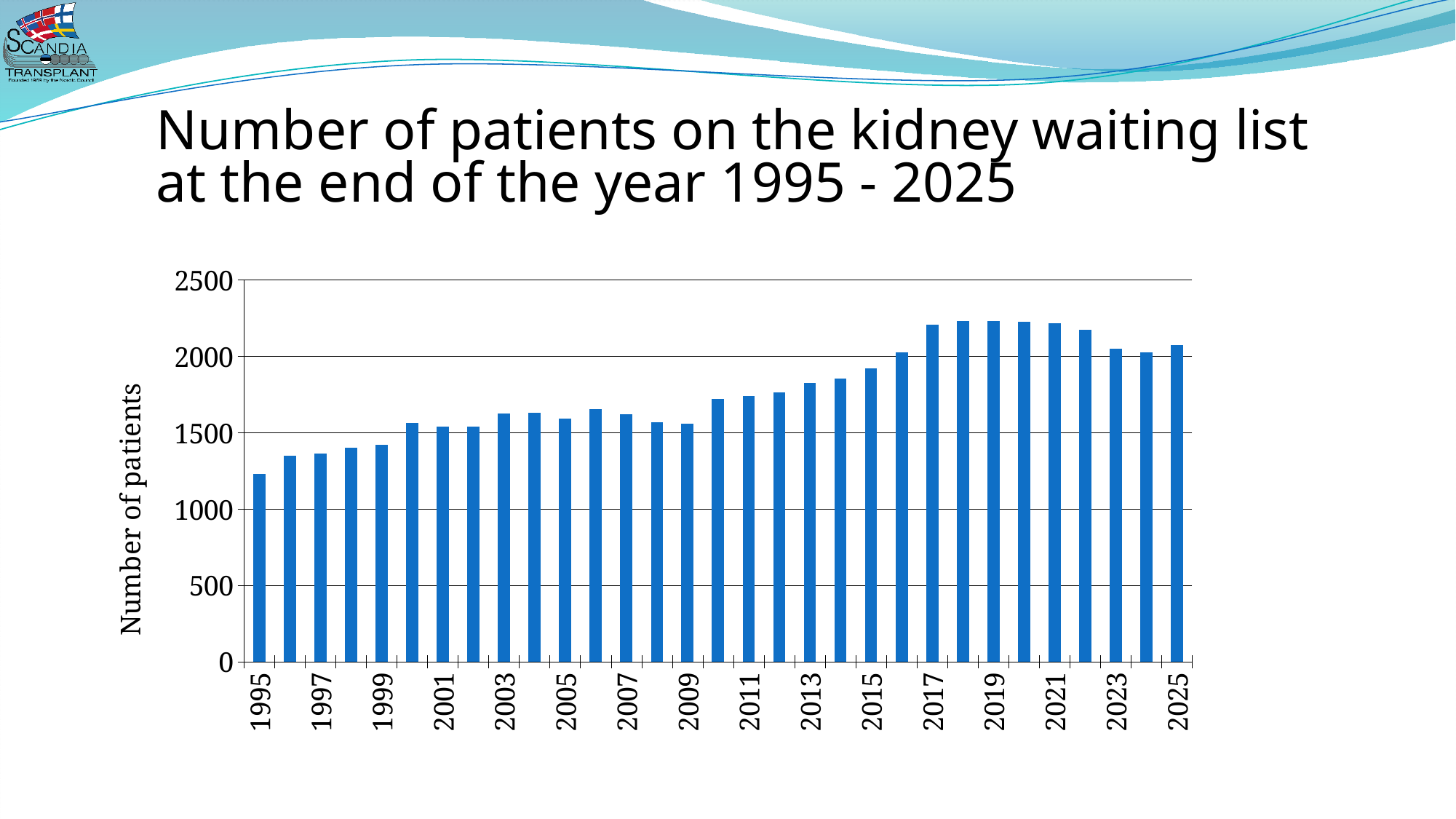
Is the value for 1995 greater or less than 1500? less Is the value for 2013 greater or less than 2000? less Which is larger, the value for 2009 or the value for 2019? 2019 Is the value for 2003 greater or less than 1500? greater Which is larger, the value for 2017 or the value for 1995? 2017 Which year has the lowest number of patients on the kidney waiting list? 1995 Do the values generally rise or fall from 1995 to 2017? rise What kind of chart is shown on the slide? bar chart What is the label on the vertical axis of the chart? Number of patients